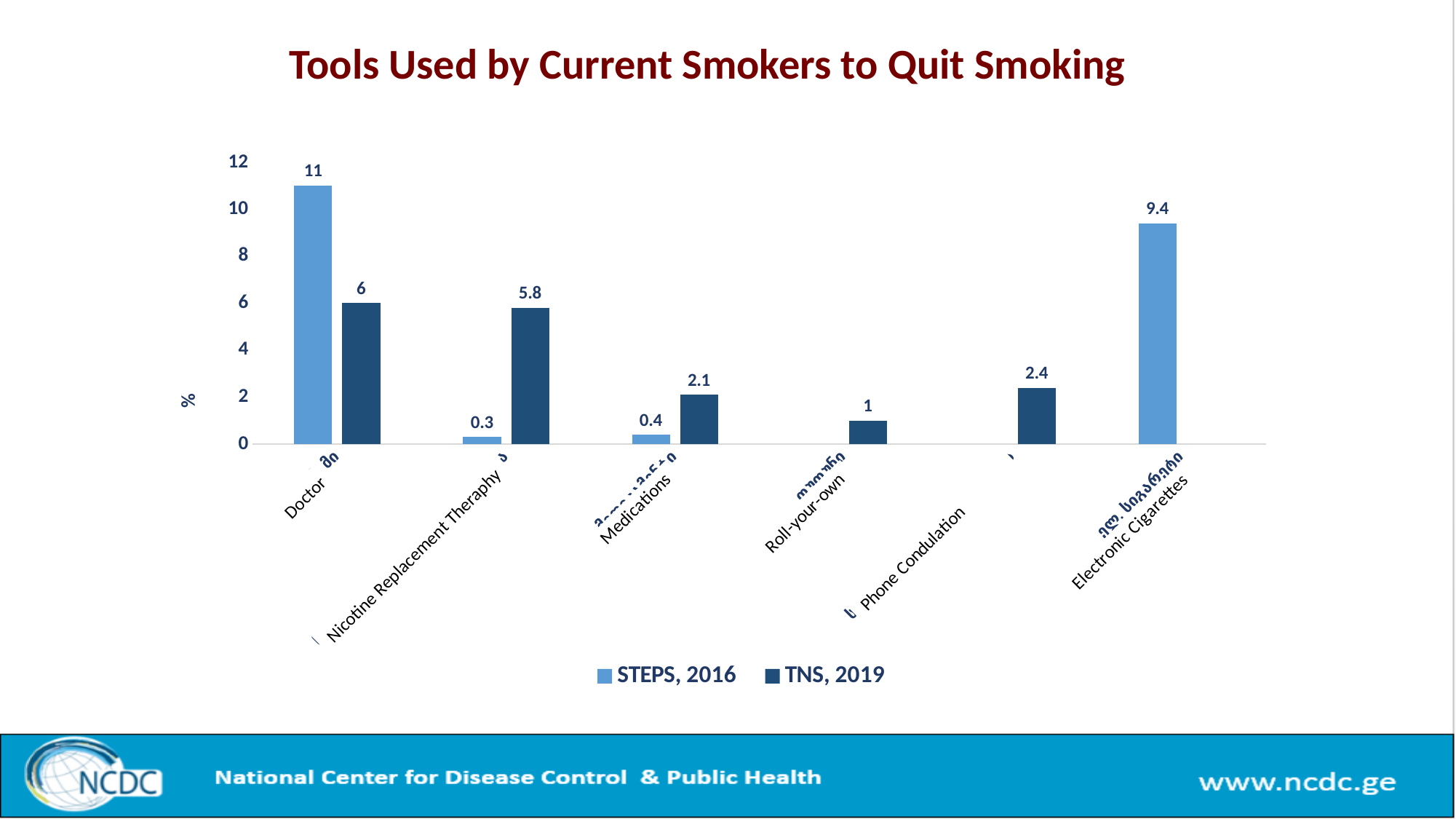
Which category has the highest STEPS, 2016 value? Doctor Which is larger for Medications: the STEPS, 2016 value or the TNS, 2019 value? TNS, 2019 What is the STEPS, 2016 value for Doctor? 11 What is the STEPS, 2016 value for Electronic Cigarettes? 9.4 How many series does the legend list? 2 What is the title of the chart? Tools Used by Current Smokers to Quit Smoking What is the TNS, 2019 value for Phone Condulation? 2.4 What is the difference between the STEPS, 2016 and TNS, 2019 values for Doctor? 5 Which category has the lowest TNS, 2019 value among those with a TNS, 2019 bar? Roll-your-own What is the TNS, 2019 value for Medications? 2.1 What is the TNS, 2019 value for Nicotine Replacement Theraphy? 5.8 What kind of chart is shown on the slide? Bar chart